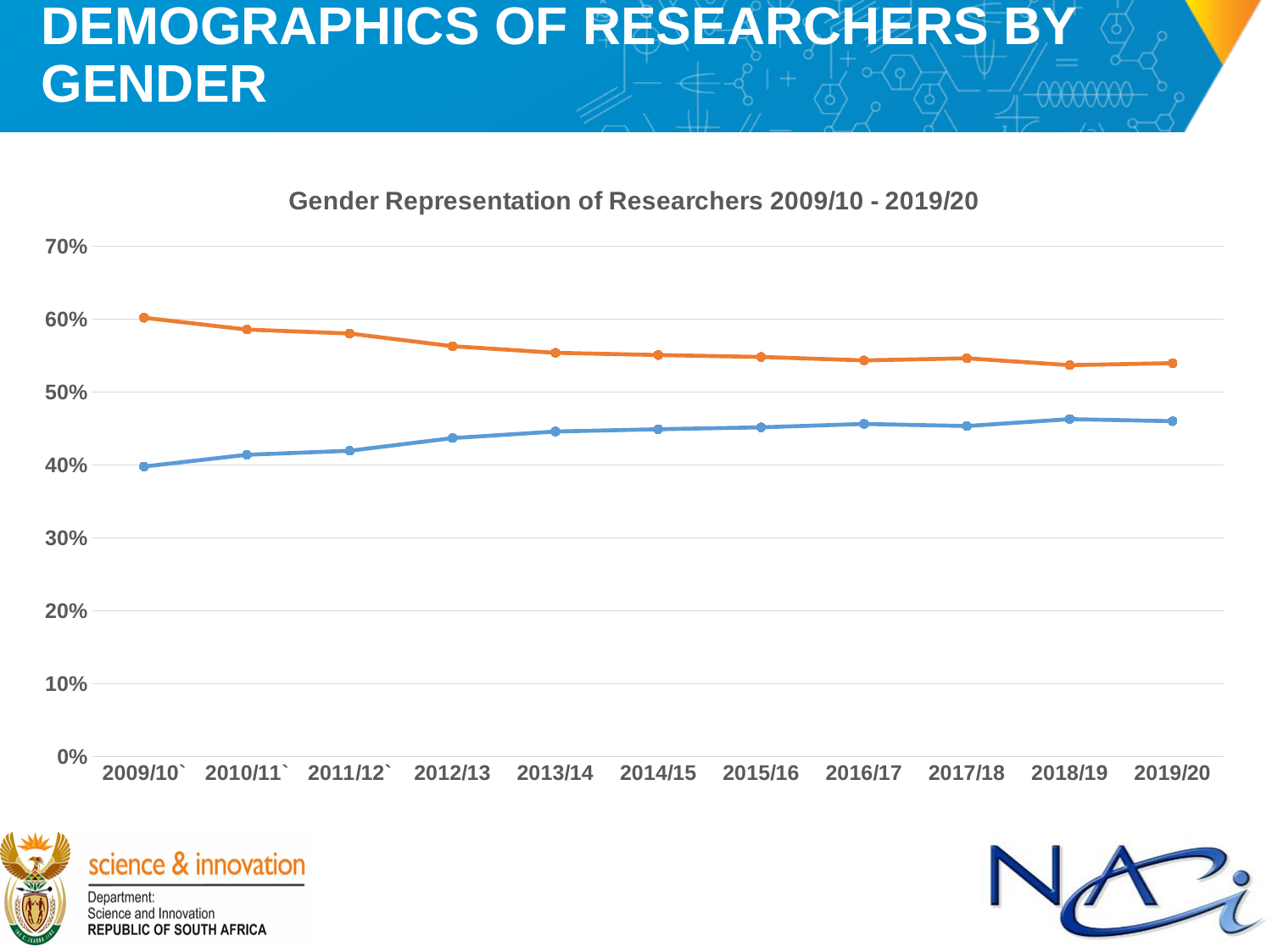
In which year does the orange line reach its highest value? 2009/10 How many years are plotted along the x axis? 11 In 2019/20, which line has the higher value, the orange line or the blue line? the orange line Is the value of the orange line for 2012/13 greater or less than 60%? less Does the orange line rise or fall from 2009/10 to 2019/20? fall What is the title of the chart? Gender Representation of Researchers 2009/10 - 2019/20 Is the value of the blue line for 2019/20 greater or less than 50%? less Is the value of the orange line for 2009/10 greater or less than 50%? greater How many lines are plotted on the chart? 2 Does the blue line rise or fall from 2009/10 to 2019/20? rise What kind of chart is shown on the slide? line chart